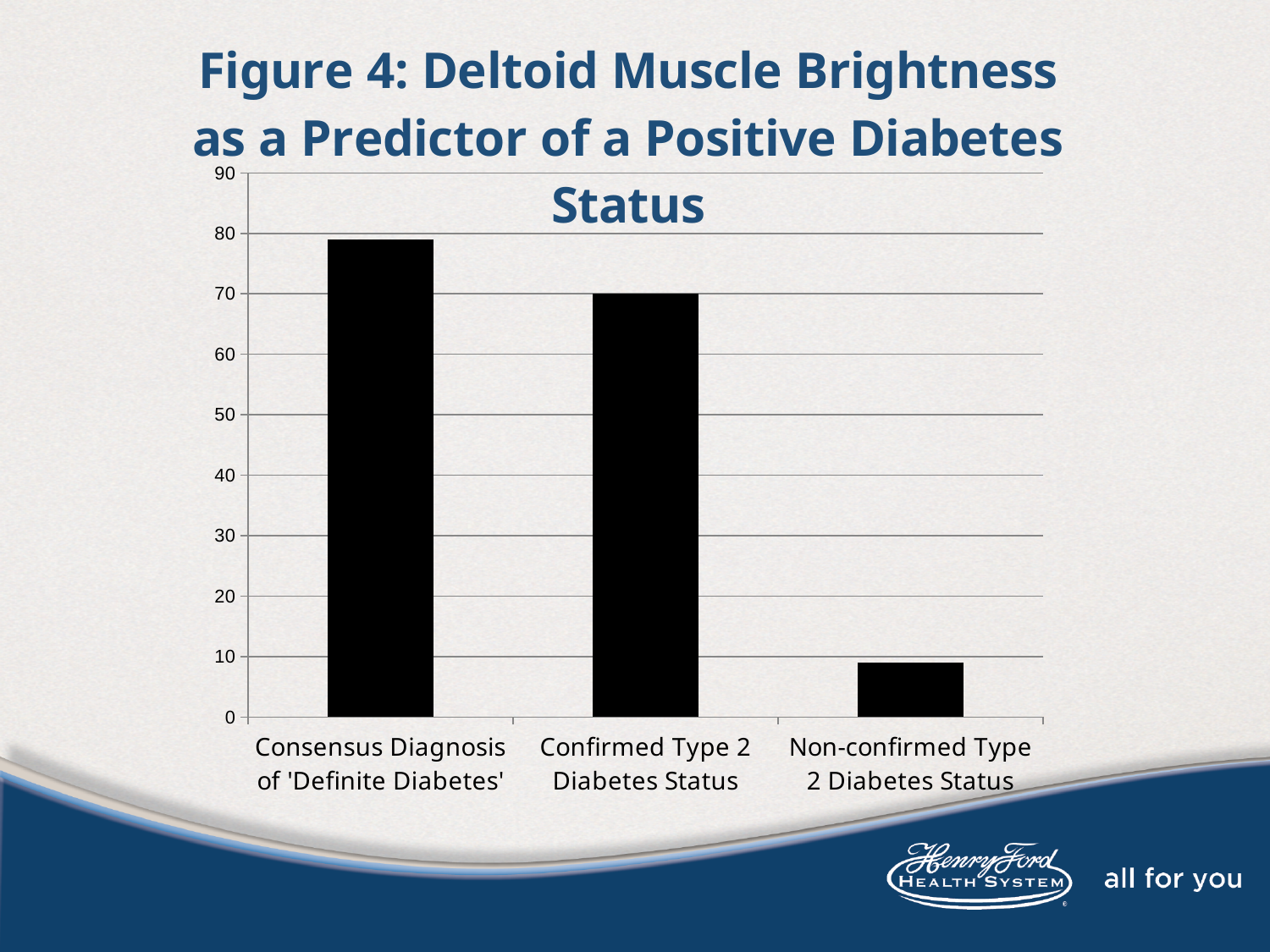
Is the value for Consensus Diagnosis of 'Definite Diabetes' greater or less than 80? less Which category has the highest bar? Consensus Diagnosis of 'Definite Diabetes' What colour are the bars in the chart? black What kind of chart is shown on the slide? bar chart How many categories are plotted in the chart? 3 Which category has the lowest bar? Non-confirmed Type 2 Diabetes Status What is the figure number given in the chart title? Figure 4 What is the value for Confirmed Type 2 Diabetes Status? 70 Do the values rise or fall from left to right across the categories? fall Is the value for Non-confirmed Type 2 Diabetes Status greater or less than 20? less Which is larger, the value for Consensus Diagnosis of 'Definite Diabetes' or the value for Confirmed Type 2 Diabetes Status? Consensus Diagnosis of 'Definite Diabetes' Is the value for Consensus Diagnosis of 'Definite Diabetes' greater or less than 70? greater